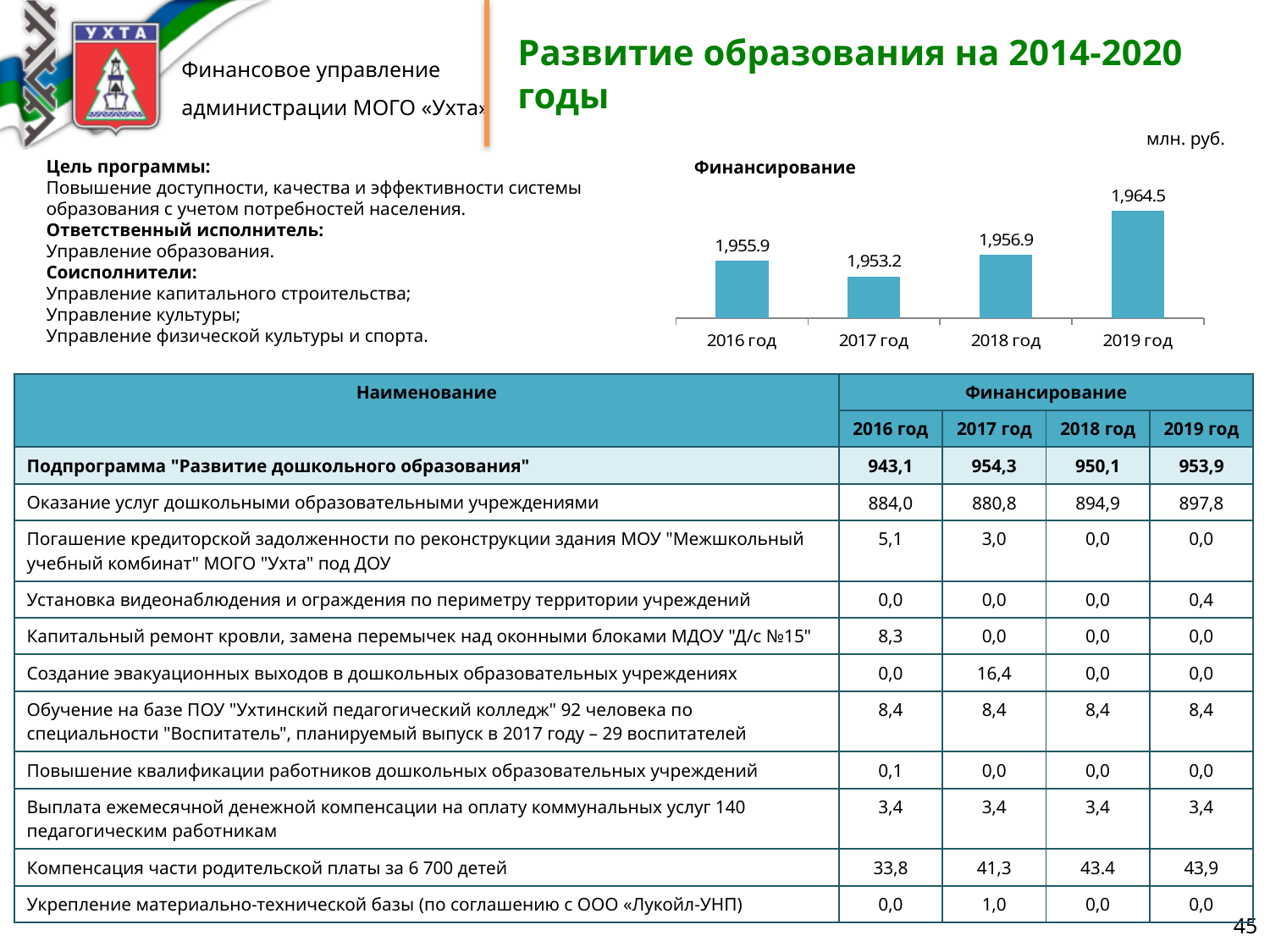
Which is larger in the Финансирование chart, the value for 2016 год or 2017 год? 2016 год Do the values in the Финансирование chart rise or fall from 2017 год to 2019 год? rise What is the value for 2017 год in the Финансирование chart? 1,953.2 Which year has the highest value in the Финансирование chart? 2019 год Which year has the lowest value in the Финансирование chart? 2017 год What is the difference between the values for 2018 год and 2016 год in the Финансирование chart? 1.0 What is the value for 2016 год in the Финансирование chart? 1,955.9 What kind of chart is the Финансирование chart? bar chart What is the value for 2018 год in the Финансирование chart? 1,956.9 How many years are shown in the Финансирование chart? 4 What is the value for 2019 год in the Финансирование chart? 1,964.5 What is the difference between the values for 2019 год and 2017 год in the Финансирование chart? 11.3